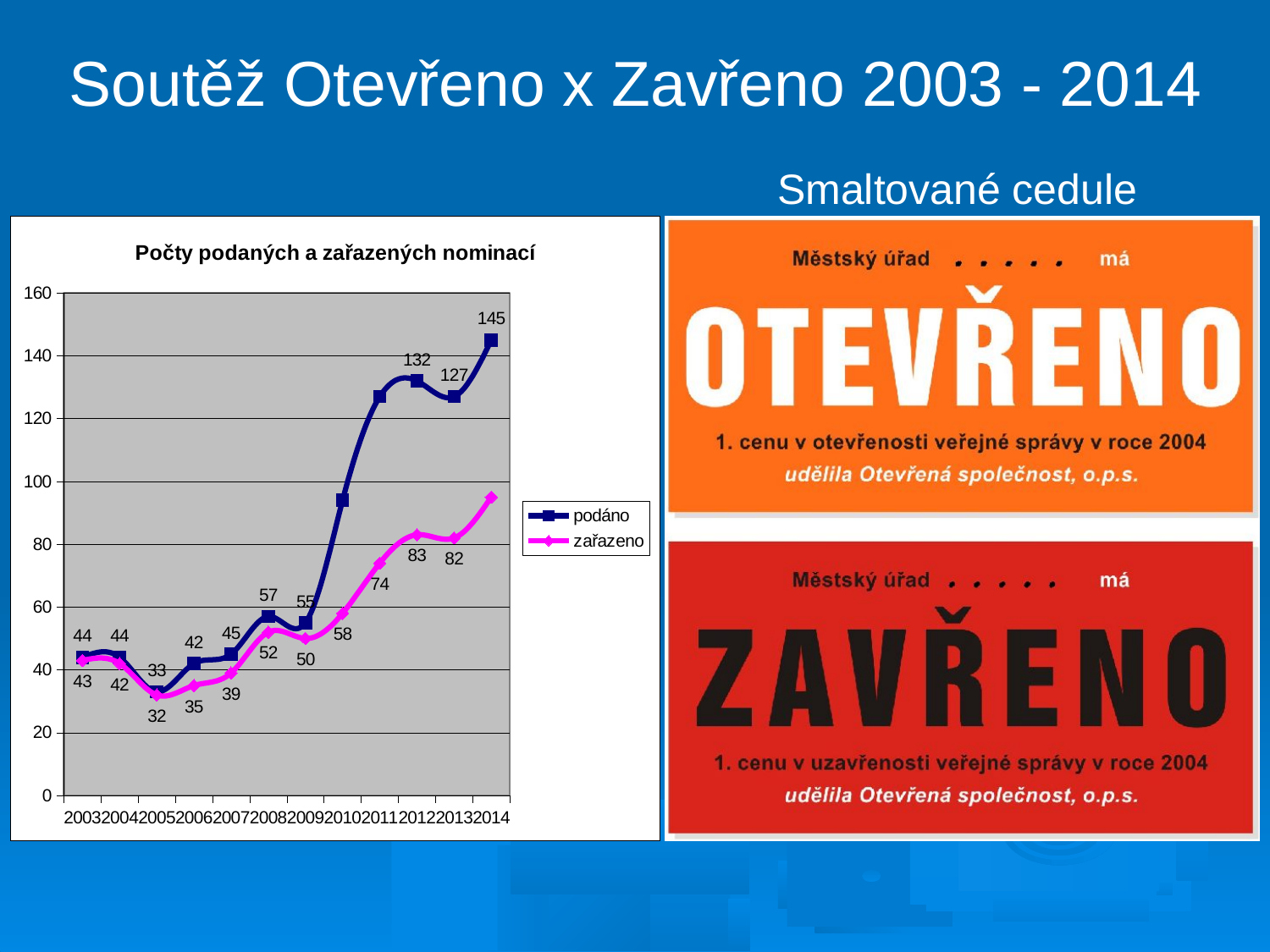
What is the difference between podáno and zařazeno in 2012? 49 What is the value of podáno in 2014? 145 What is the value of zařazeno in 2005? 32 In which year is the podáno value the highest? 2014 What is the title of the chart? Počty podaných a zařazených nominací What is the value of podáno in 2012? 132 Is the value of podáno in 2010 greater or less than 80? greater How many series does the chart legend list? 2 What is the value of zařazeno in 2011? 74 How many years are plotted on the x axis? 12 What type of chart is shown on the slide? line chart In which year is the podáno value the lowest? 2005